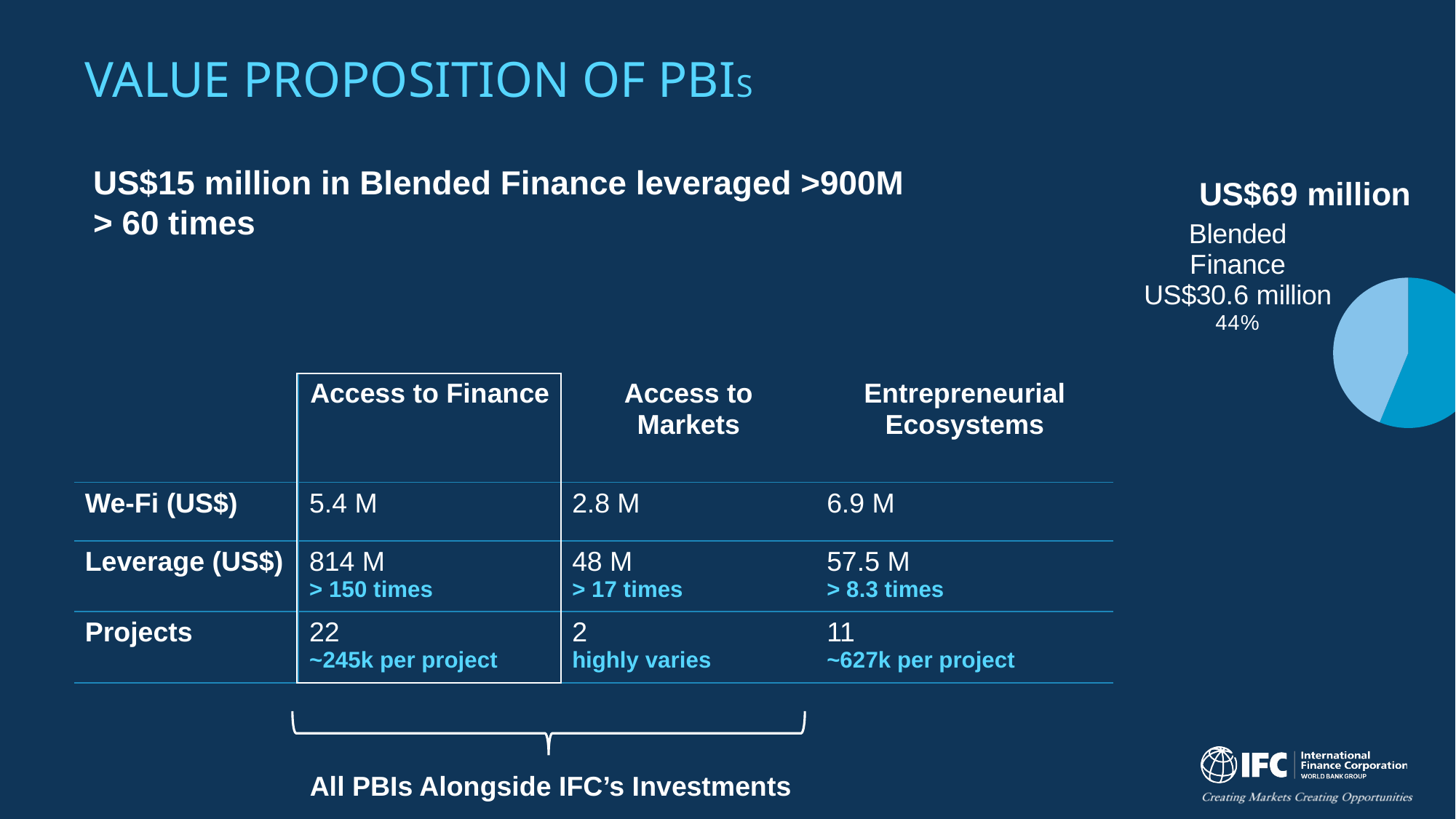
In the pie chart, what is the value labelled for Blended Finance? US$30.6 million How many slices does the pie chart have? 2 What kind of chart is shown on the right side of the slide? pie chart Which slice of the pie chart is larger: the Blended Finance slice or the other slice? the other slice What colour is the Blended Finance slice in the pie chart? light blue What total amount is shown above the pie chart? US$69 million Is the Blended Finance slice of the pie chart more or less than half of the pie? less In the pie chart, what share of the total does Blended Finance represent? 44%